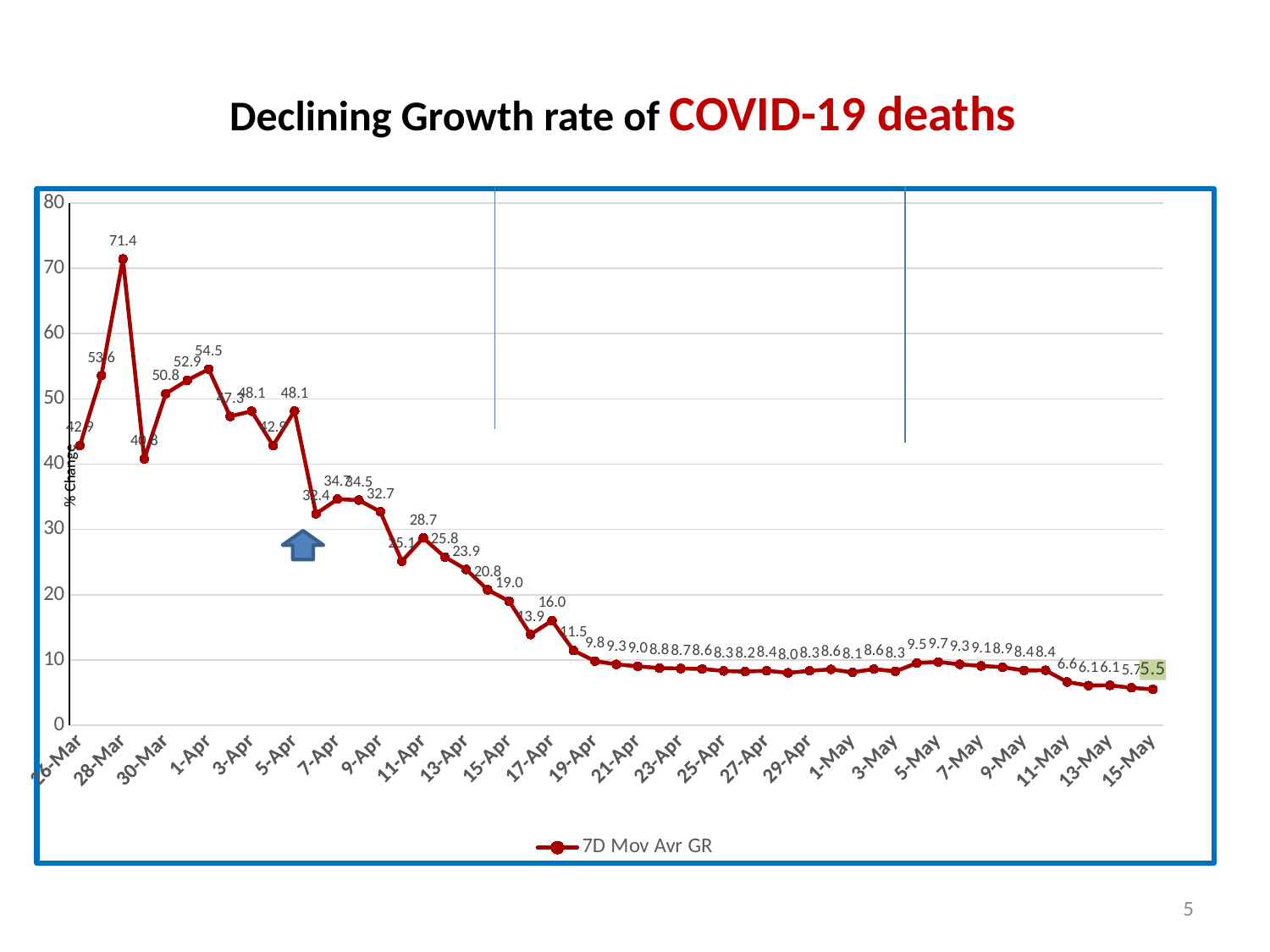
Which date has the larger value, 30-Mar or 1-Apr? 1-Apr What is the value plotted for 17-Apr? 16.0 On which date is the growth rate at its lowest value? 15-May What is the value plotted for 15-May? 5.5 On which date does the growth rate reach its highest value? 28-Mar Overall, does the growth rate rise or fall from 26-Mar to 15-May? Fall What is the 7D Mov Avr GR value on 28-Mar? 71.4 What is the difference between the highest value (28-Mar) and the lowest value (15-May)? 65.9 What type of chart is shown on the slide? Line chart Is the value for 5-Apr greater or less than 40? greater How many series does the legend list? 1 What is the value plotted for 1-Apr? 54.5